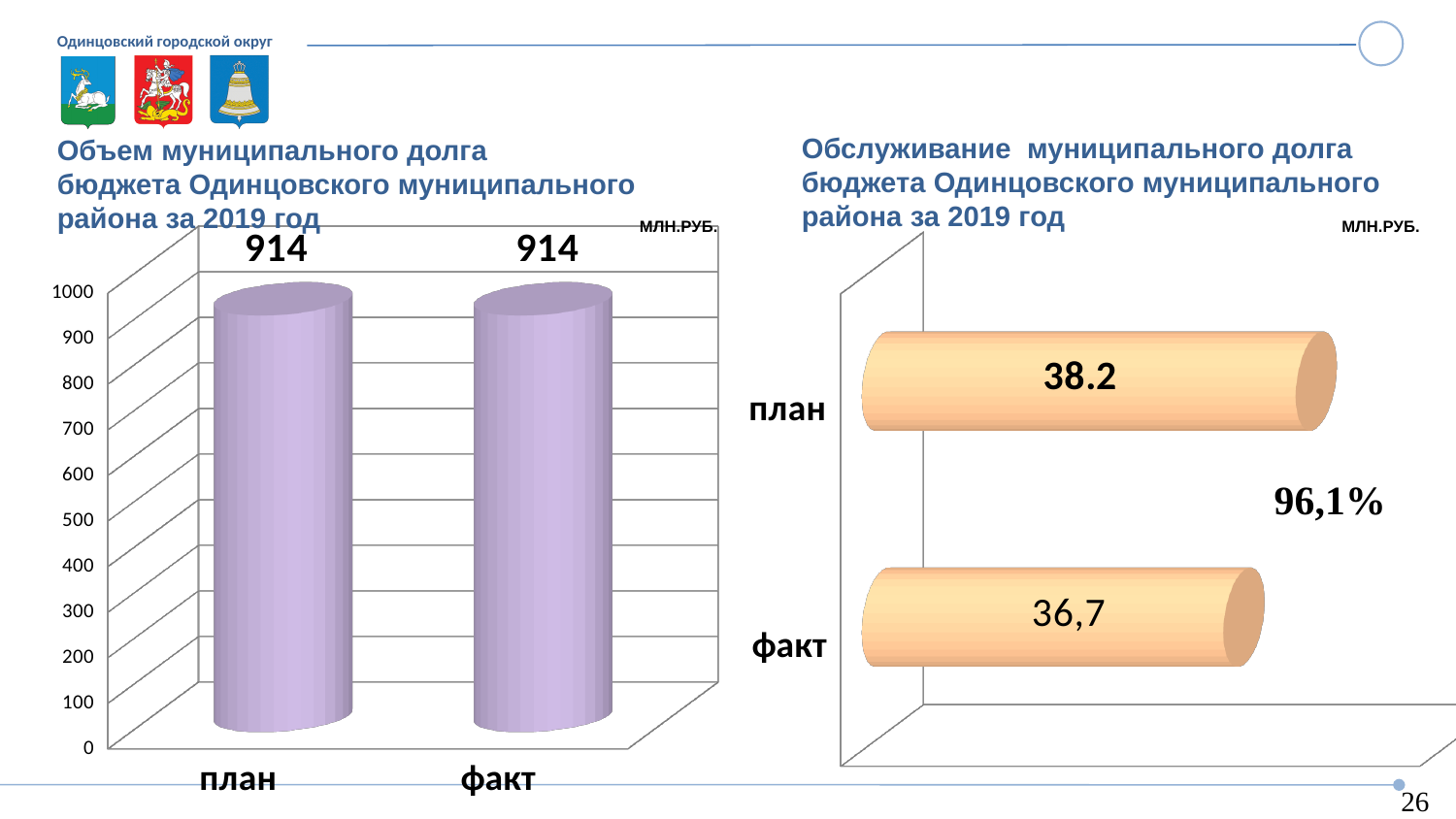
In the right chart (Обслуживание муниципального долга), what is the value for факт? 36,7 In the right chart (Обслуживание муниципального долга), how many bars are shown? 2 In the left chart (Объем муниципального долга), what kind of chart is it? bar chart In the right chart (Обслуживание муниципального долга), what percentage is shown between the two bars? 96,1% In the left chart (Объем муниципального долга), how many categories are shown? 2 In the right chart (Обслуживание муниципального долга), which category has the higher value, план or факт? план In the left chart (Объем муниципального долга), what is the value for план? 914 In the right chart (Обслуживание муниципального долга), what is the value for план? 38.2 In the left chart (Объем муниципального долга), what is the value for факт? 914 In the right chart (Обслуживание муниципального долга), what kind of chart is it? bar chart In the left chart (Объем муниципального долга), what is the difference between план and факт? 0 In the left chart (Объем муниципального долга), what unit is indicated next to the chart? МЛН.РУБ.